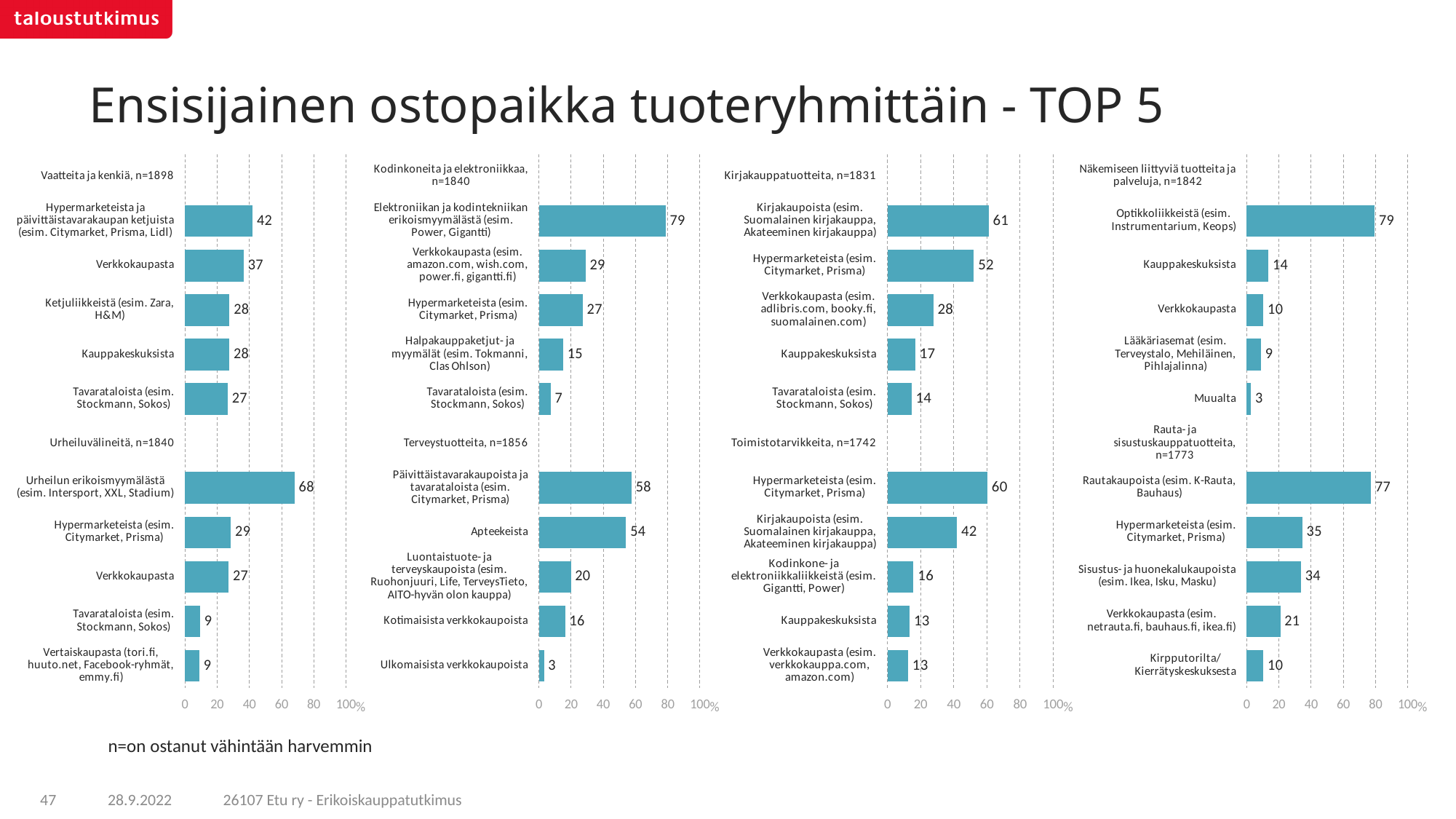
In the Kodinkoneita ja elektroniikkaa section, what is the value for Tavarataloista (esim. Stockmann, Sokos)? 7 How many categories are plotted in the Terveystuotteita section? 5 In the Urheiluvälineitä section, which category has the highest value? Urheilun erikoismyymälästä (esim. Intersport, XXL, Stadium) In the Vaatteita ja kenkiä section, what is the value for Verkkokaupasta? 37 In the Rauta- ja sisustuskauppatuotteita section, which is larger: Rautakaupoista or Hypermarketeista? Rautakaupoista In the Toimistotarvikkeita section, what is the value for Hypermarketeista (esim. Citymarket, Prisma)? 60 In the Näkemiseen liittyviä tuotteita ja palveluja section, what is the value for Optikkoliikkeistä? 79 In the Rauta- ja sisustuskauppatuotteita section, what is the difference between Rautakaupoista and Verkkokaupasta? 56 What is the title of the slide? Ensisijainen ostopaikka tuoteryhmittäin - TOP 5 In the Terveystuotteita section, what is the difference between Päivittäistavarakaupoista ja tavarataloista and Apteekeista? 4 What type of chart is used on this slide? Bar chart In the Kirjakauppatuotteita section, which category has the lowest value? Tavarataloista (esim. Stockmann, Sokos)